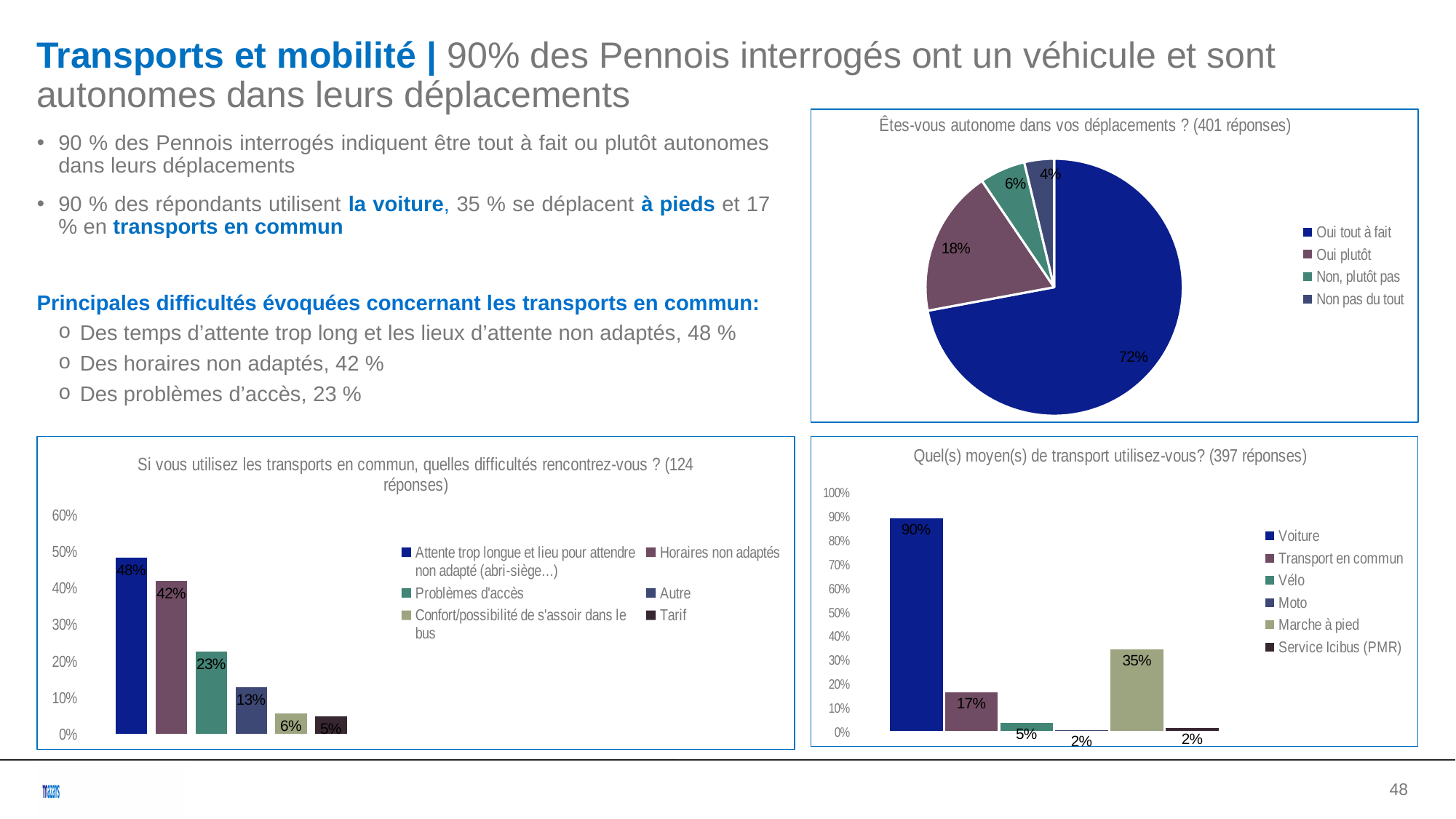
In the bottom-left chart 'Si vous utilisez les transports en commun, quelles difficultés rencontrez-vous ?', which category has the highest value? Attente trop longue et lieu pour attendre non adapté (abri-siège…) In the pie chart 'Êtes-vous autonome dans vos déplacements ?', what share is labelled for 'Oui tout à fait'? 72% How many categories are shown in the bottom-right chart 'Quel(s) moyen(s) de transport utilisez-vous?'? 6 In the bottom-right chart 'Quel(s) moyen(s) de transport utilisez-vous?', which is larger, 'Transport en commun' or 'Vélo'? Transport en commun In the pie chart 'Êtes-vous autonome dans vos déplacements ?', which category has the smallest slice? Non pas du tout In the bottom-left chart 'Si vous utilisez les transports en commun, quelles difficultés rencontrez-vous ?', what is the value for 'Horaires non adaptés'? 42% In the bottom-right chart 'Quel(s) moyen(s) de transport utilisez-vous?', what is the value for 'Marche à pied'? 35% In the pie chart 'Êtes-vous autonome dans vos déplacements ?', what share is labelled for 'Oui plutôt'? 18% What kind of chart is the bottom-left chart 'Si vous utilisez les transports en commun, quelles difficultés rencontrez-vous ?'? Bar chart In the bottom-right chart 'Quel(s) moyen(s) de transport utilisez-vous?', what is the difference between 'Voiture' and 'Transport en commun'? 73% In the bottom-left chart 'Si vous utilisez les transports en commun, quelles difficultés rencontrez-vous ?', what is the difference between 'Problèmes d'accès' and 'Autre'? 10% How many entries does the legend of the pie chart 'Êtes-vous autonome dans vos déplacements ?' list? 4